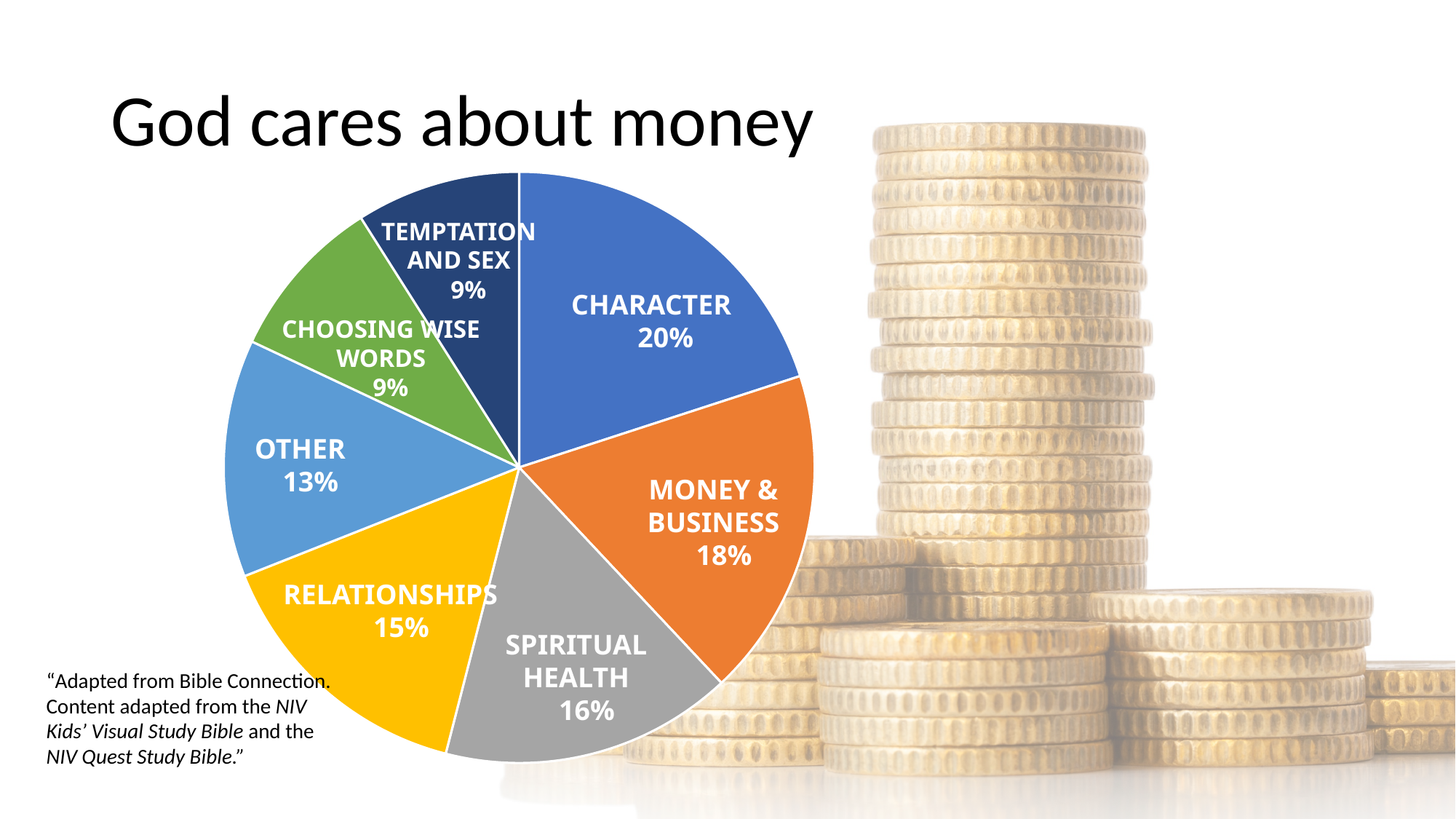
What is the difference between the Character and Money & Business slices? 2% What is the value for Relationships? 15% What is the value for Other? 13% What kind of chart is shown on the slide? Pie chart Which is larger, Relationships or Other? Relationships What is the value for Choosing Wise Words? 9% How many slices does the pie chart have? 7 What is the value for Spiritual Health? 16% What is the value for Money & Business? 18% What share of the pie does Character have? 20% Which category has the largest slice of the pie? Character What is the title of the slide containing the pie chart? God cares about money